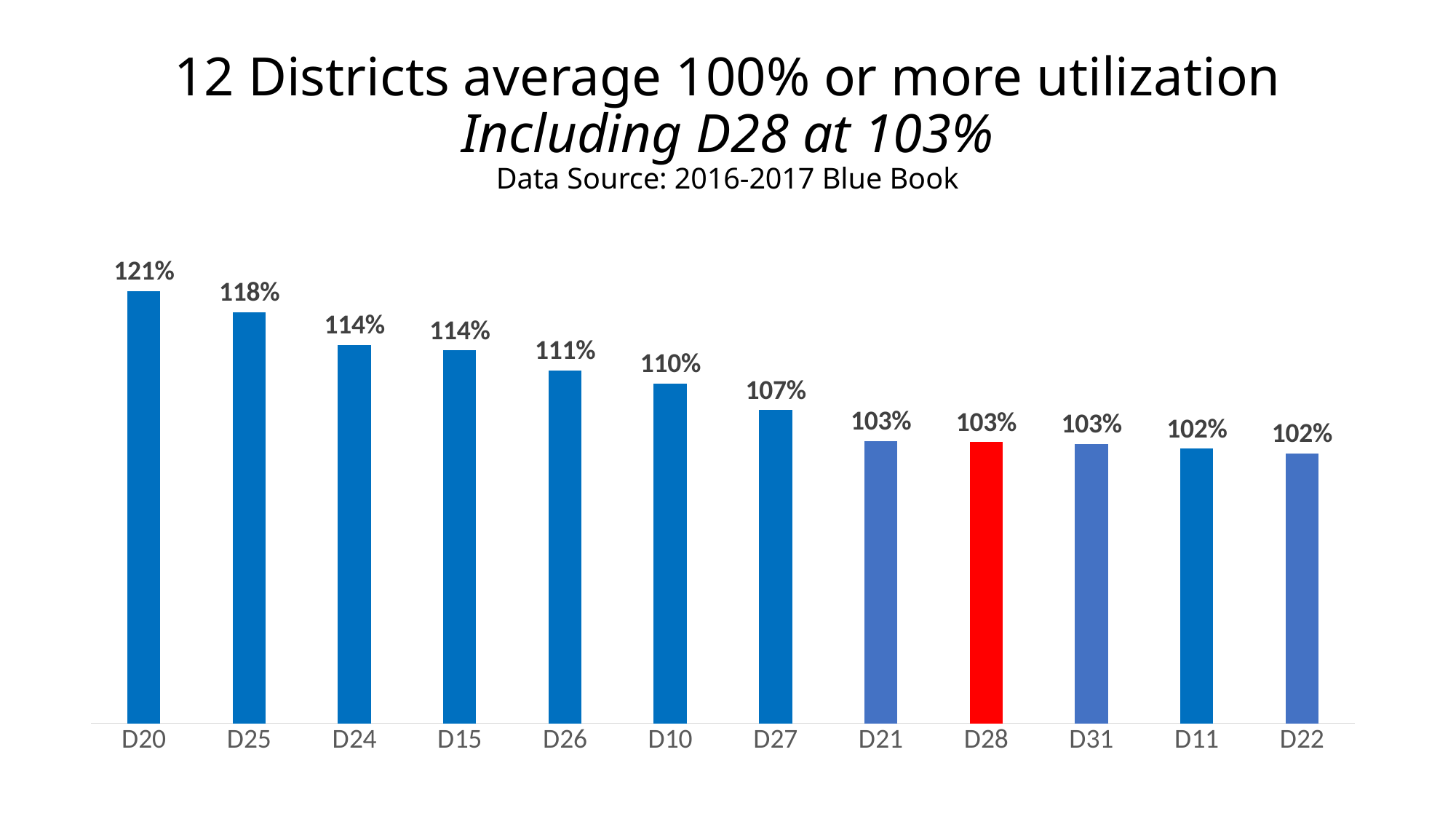
What is the utilization value for D11? 102% How many districts are shown in the chart? 12 What is the difference between the utilization of D20 and D25? 3% Which district has the highest utilization? D20 Do the values rise or fall from left to right along the x axis? Fall What is the utilization value for D27? 107% What is the difference between the utilization of D10 and D28? 7% Which district's bar is coloured red? D28 Which has a higher utilization, D26 or D27? D26 What is the utilization value for D20? 121% What kind of chart is shown on the slide? Bar chart What is the utilization value for D28? 103%